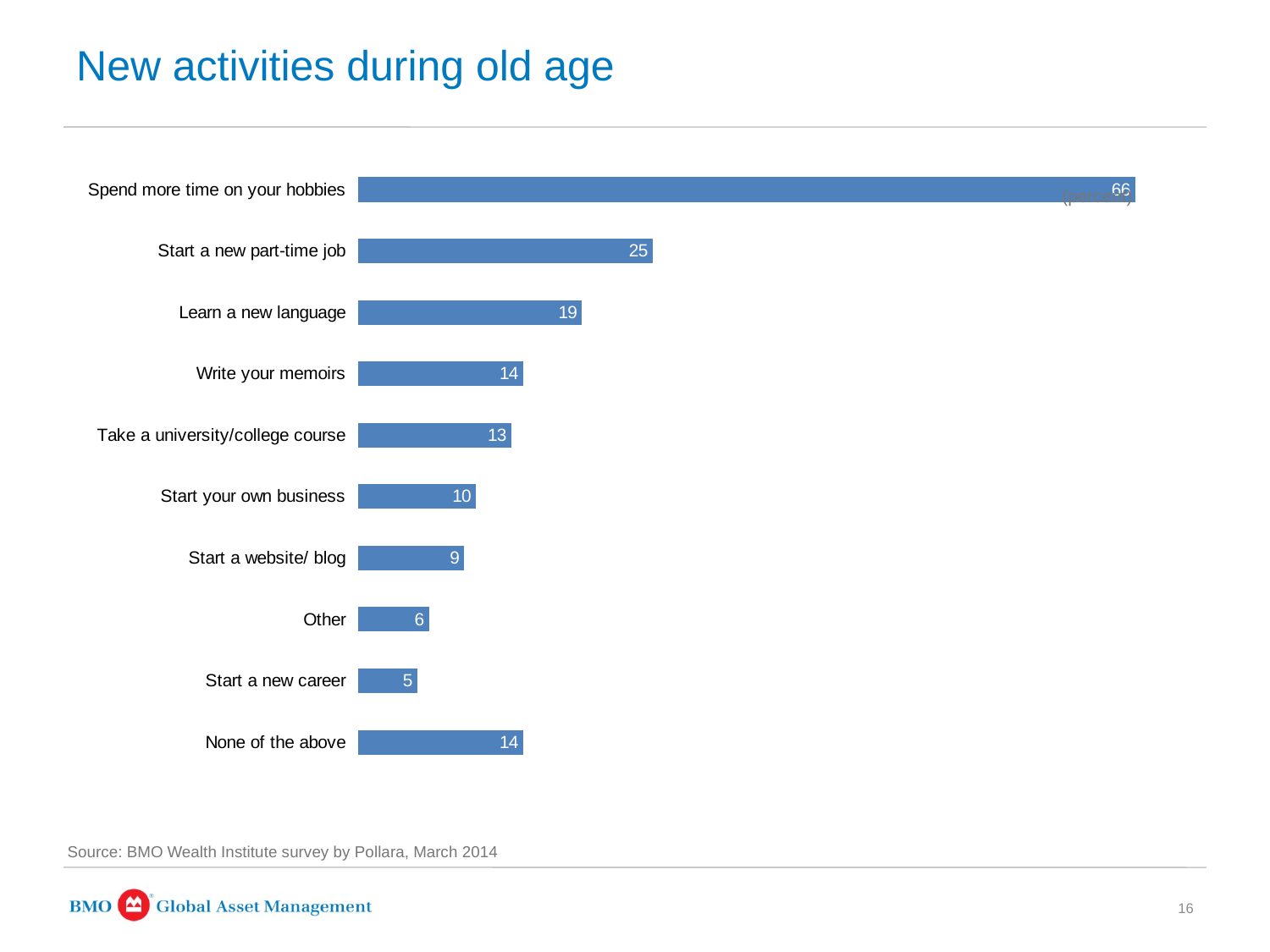
What kind of chart is shown on the slide? Bar chart What is the value for "Start a website/ blog"? 9 What is the value for "Start a new part-time job"? 25 What is the value for "Learn a new language"? 19 Which category has the highest value? Spend more time on your hobbies What is the difference between the values for "Spend more time on your hobbies" and "Start a new part-time job"? 41 What is the difference between the values for "Learn a new language" and "Write your memoirs"? 5 Which is larger, the value for "Start your own business" or the value for "Take a university/college course"? Take a university/college course What is the title of the slide? New activities during old age How many categories are shown in the chart? 10 Which category has the lowest value? Start a new career What is the value for "Spend more time on your hobbies"? 66